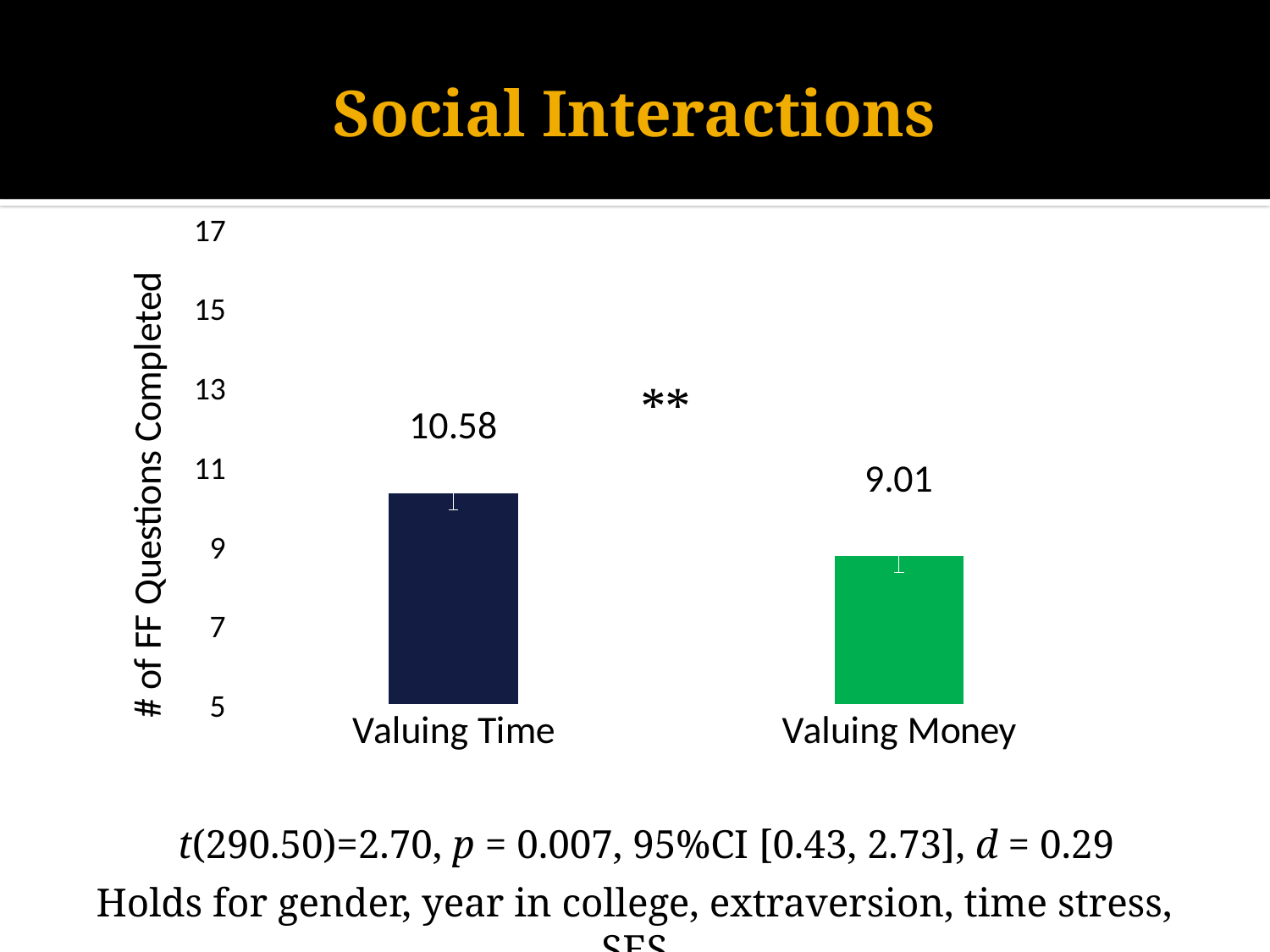
What colour is the bar for Valuing Money? green What is the value for Valuing Money? 9.01 Which category has the lowest number of FF questions completed? Valuing Money What is the difference between the values for Valuing Time and Valuing Money? 1.57 What is the value for Valuing Time? 10.58 Is the value for Valuing Time greater or less than 9? greater What kind of chart is shown on the slide? bar chart Is the value for Valuing Money greater or less than 11? less How many categories are shown in the chart? 2 What is the label of the vertical axis? # of FF Questions Completed Which is larger, the value for Valuing Time or the value for Valuing Money? Valuing Time Which category has the highest number of FF questions completed? Valuing Time